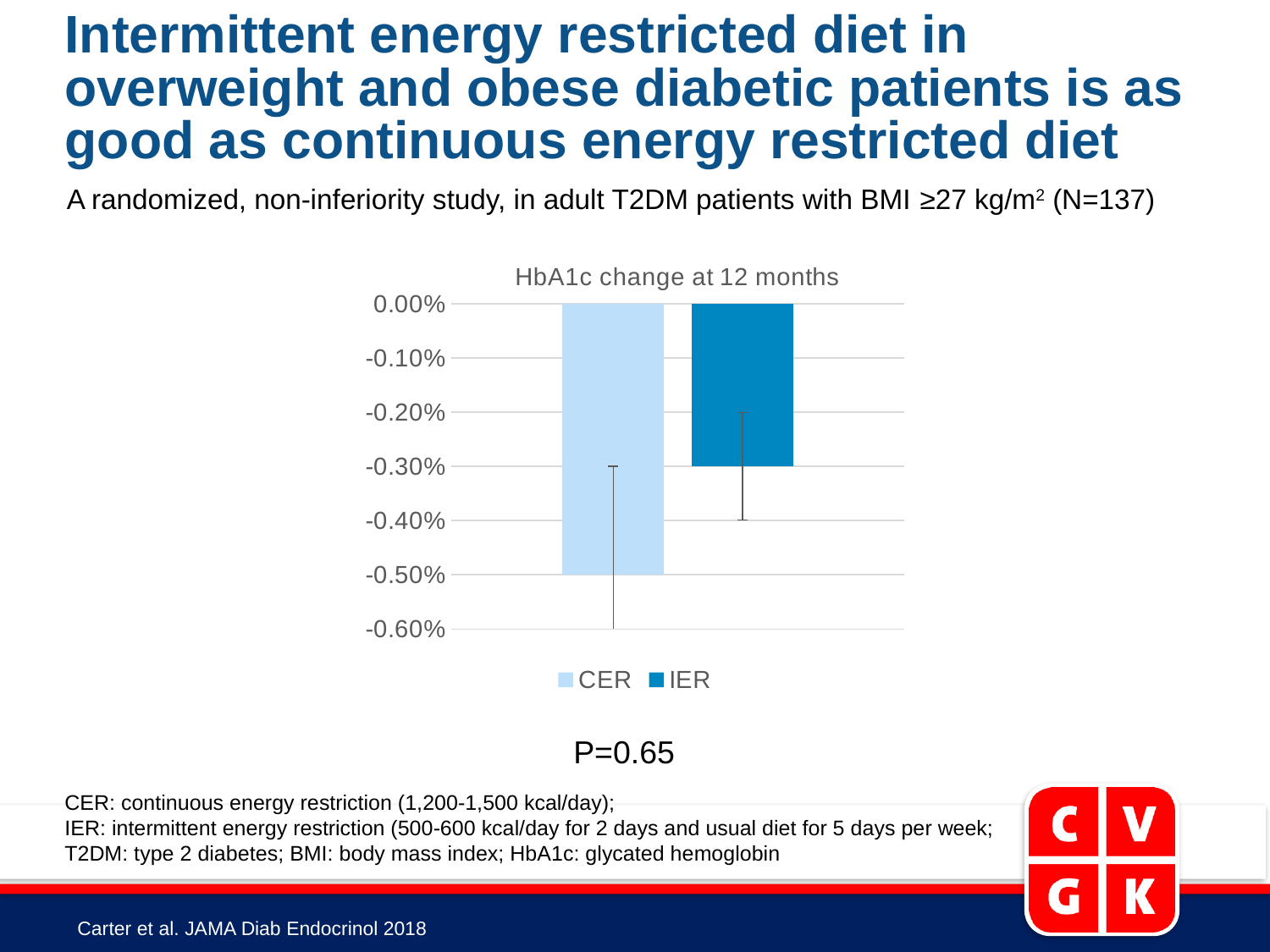
What is the HbA1c change at 12 months for CER? -0.50% What is the HbA1c change at 12 months for IER? -0.30% Is the HbA1c change for CER greater or less than -0.40%? less What is the difference between the HbA1c change for CER and for IER? 0.20% Is the HbA1c change for IER greater or less than -0.40%? greater What is the title of the chart? HbA1c change at 12 months Which group shows the highest (least negative) HbA1c change at 12 months? IER Which series are listed in the chart legend? CER and IER How many bars are plotted in the chart? 2 Which group shows the lowest (most negative) HbA1c change at 12 months? CER What kind of chart is shown on the slide? Bar chart How many series does the chart legend list? 2